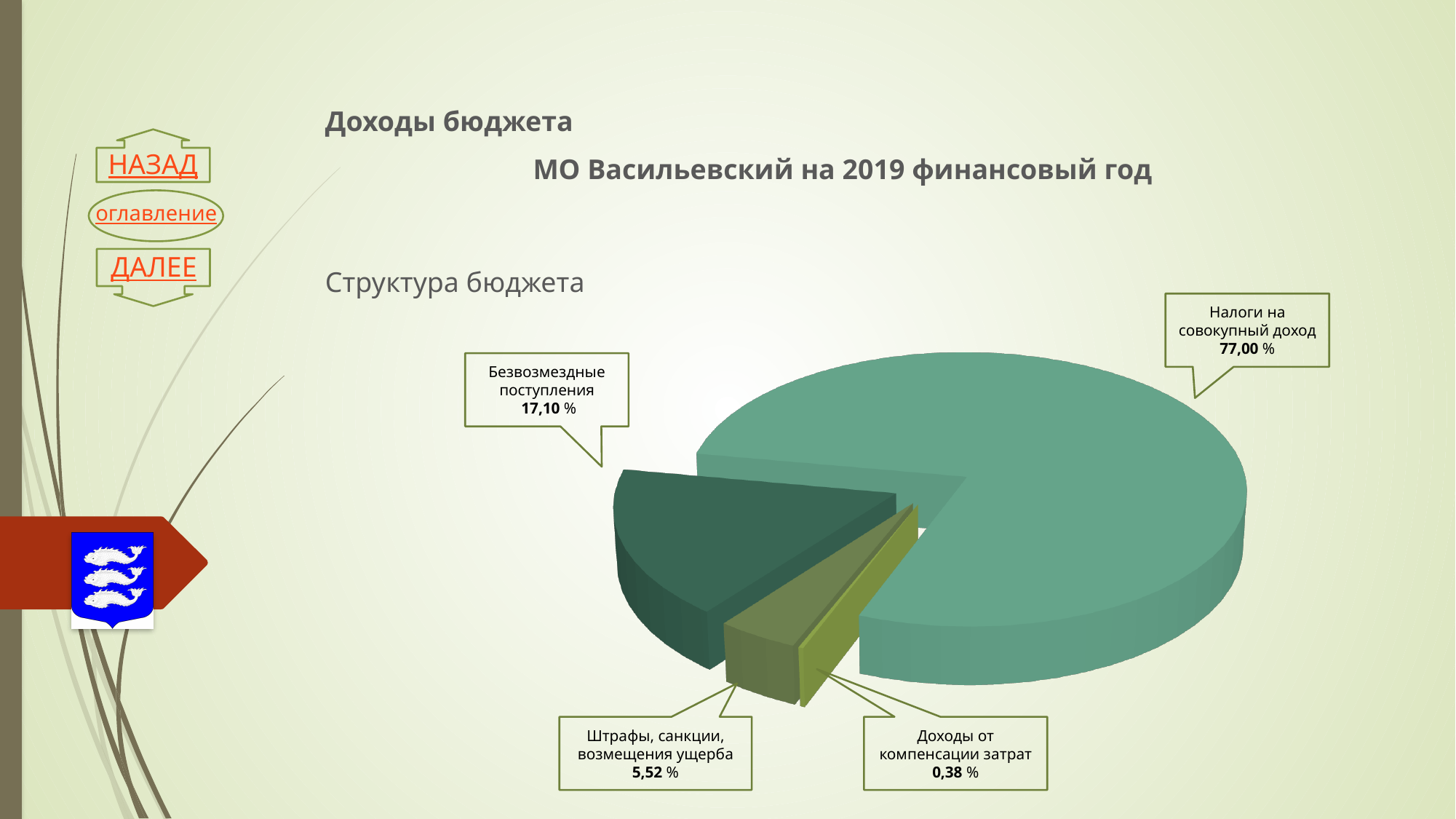
How many slices does the pie chart have? 4 Which category has the smallest slice of the pie chart? Доходы от компенсации затрат Which is larger: 'Штрафы, санкции, возмещения ущерба' or 'Доходы от компенсации затрат'? Штрафы, санкции, возмещения ущерба What is the difference between 'Безвозмездные поступления' and 'Штрафы, санкции, возмещения ущерба'? 11,58 % What type of chart is shown on the slide? Pie chart What share of the budget structure pie chart is 'Налоги на совокупный доход'? 77,00 % Which category has the largest slice of the pie chart? Налоги на совокупный доход What percentage is shown for 'Безвозмездные поступления' in the pie chart? 17,10 % What is the heading shown above the pie chart? Структура бюджета What percentage is shown for 'Доходы от компенсации затрат'? 0,38 % What is the difference in percentage points between 'Налоги на совокупный доход' and 'Безвозмездные поступления'? 59,90 % What percentage is shown for 'Штрафы, санкции, возмещения ущерба'? 5,52 %